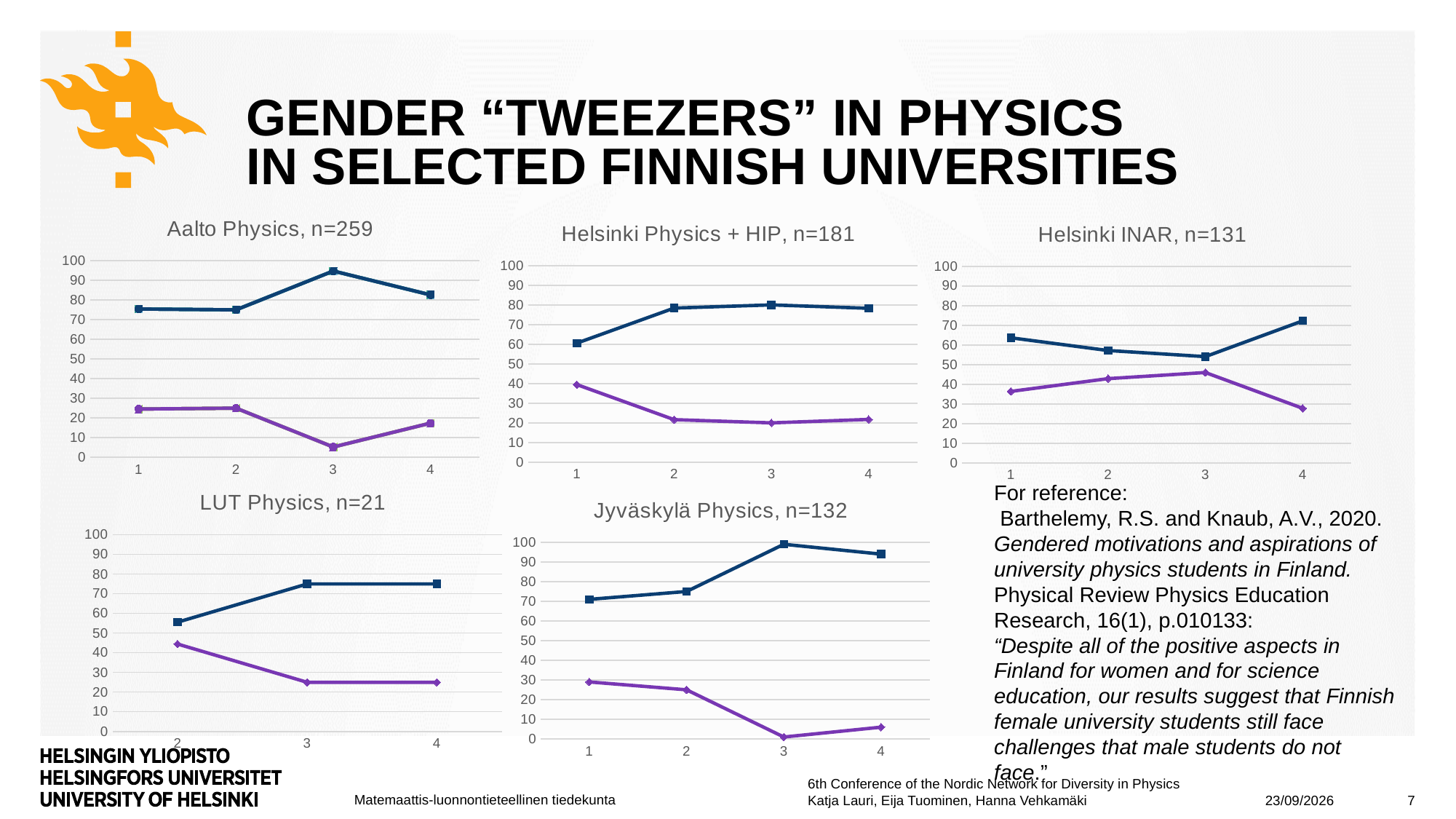
In the Helsinki INAR, n=131 chart, at which x value is the lower (purple) line lowest? 4 In the Jyväskylä Physics, n=132 chart, at which x value is the upper (blue) line highest? 3 In the Helsinki INAR, n=131 chart, does the lower (purple) line rise or fall from x=1 to x=3? rise How many charts are shown on the slide? 5 In the Jyväskylä Physics, n=132 chart, does the lower (purple) line rise or fall from x=1 to x=3? fall In the LUT Physics, n=21 chart, is the value of the lower (purple) line at x=3 greater or less than 30? less What kind of chart is the Aalto Physics, n=259 chart? line chart In the Helsinki Physics + HIP, n=181 chart, at which x value is the upper (blue) line lowest? 1 In the Helsinki INAR, n=131 chart, is the value of the upper (blue) line at x=4 greater or less than 70? greater In the Aalto Physics, n=259 chart, is the value of the upper (blue) line at x=3 greater or less than 90? greater How many points along the x axis does the Aalto Physics, n=259 chart have? 4